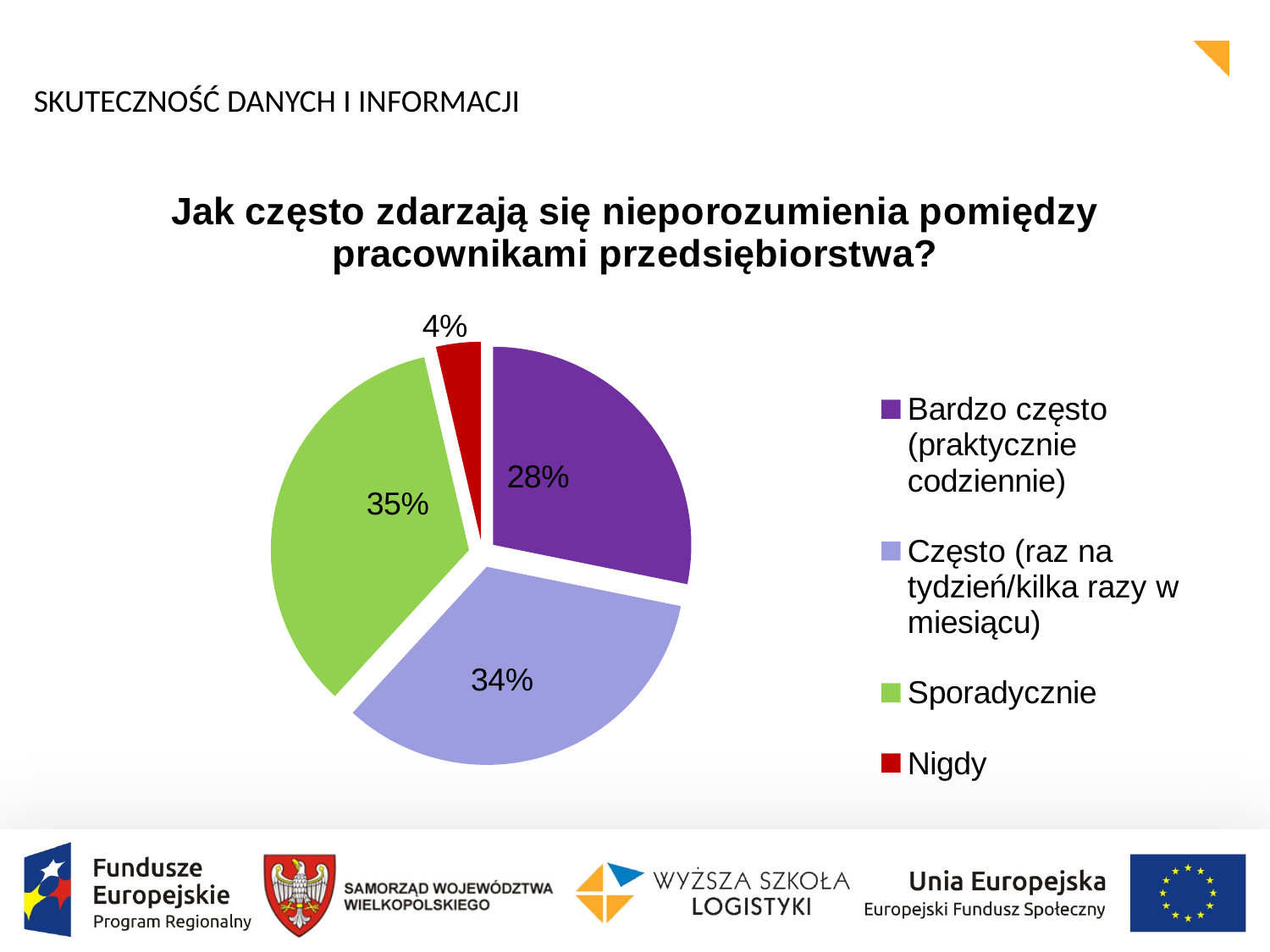
Which category has the smallest share of the pie? Nigdy What percentage of the pie corresponds to "Nigdy"? 4% What type of chart is shown on the slide? pie chart What is the title of the pie chart? Jak często zdarzają się nieporozumienia pomiędzy pracownikami przedsiębiorstwa? Which category has the largest share of the pie? Sporadycznie What percentage is shown for "Bardzo często (praktycznie codziennie)"? 28% How many categories does the pie chart have? 4 What colour is the slice for "Nigdy"? red What percentage of the pie corresponds to "Sporadycznie"? 35% Which is larger: the share for "Często (raz na tydzień/kilka razy w miesiącu)" or the share for "Bardzo często (praktycznie codziennie)"? Często (raz na tydzień/kilka razy w miesiącu) What percentage is shown for "Często (raz na tydzień/kilka razy w miesiącu)"? 34% What is the difference in percentage points between "Sporadycznie" and "Nigdy"? 31